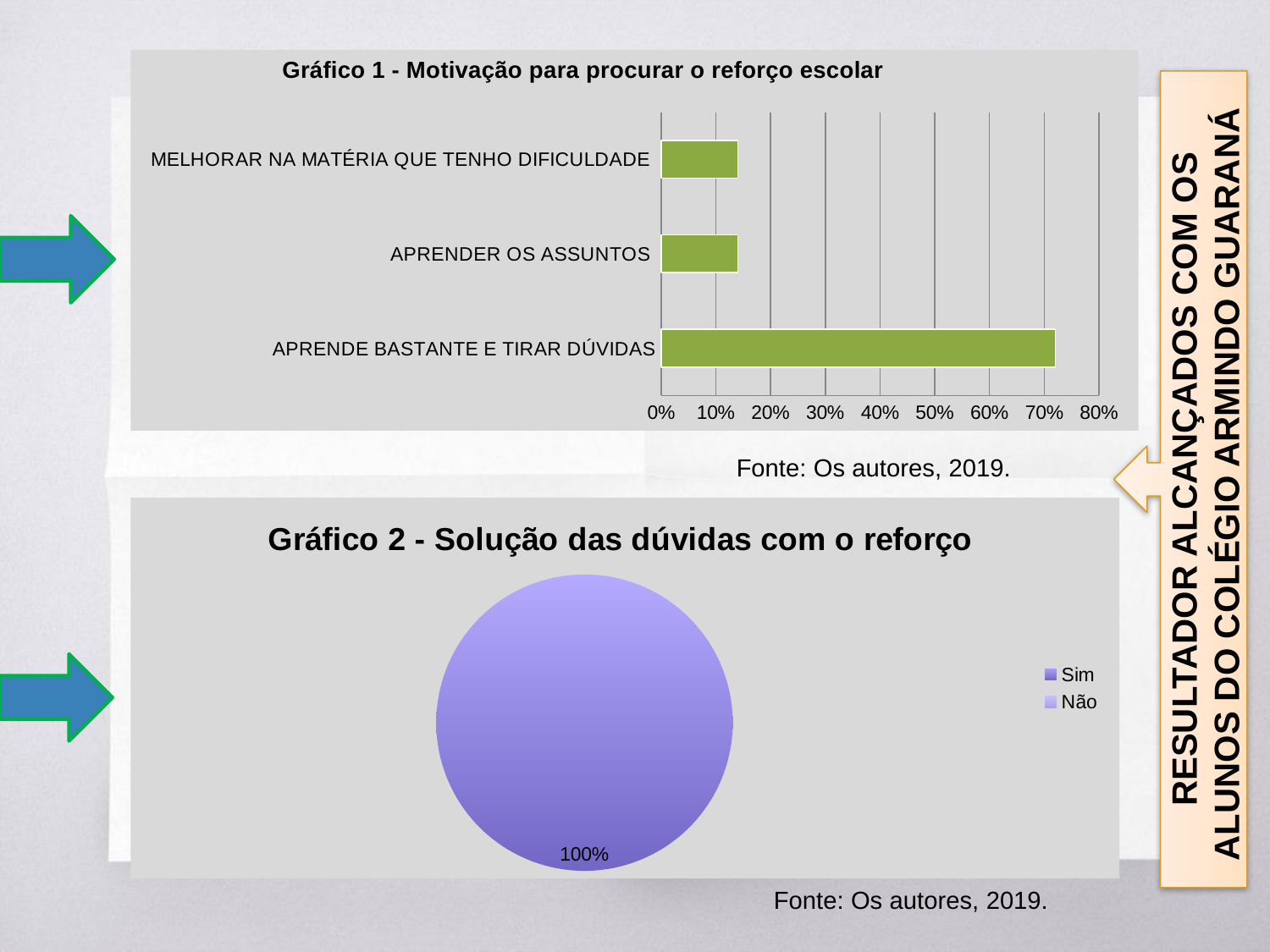
In Gráfico 2 - Solução das dúvidas com o reforço, what share of the pie does Sim represent? 100% In Gráfico 1 - Motivação para procurar o reforço escolar, is the value for APRENDER OS ASSUNTOS greater or less than 30%? less In Gráfico 1 - Motivação para procurar o reforço escolar, which is larger: APRENDE BASTANTE E TIRAR DÚVIDAS or APRENDER OS ASSUNTOS? APRENDE BASTANTE E TIRAR DÚVIDAS In Gráfico 1 - Motivação para procurar o reforço escolar, is the value for APRENDE BASTANTE E TIRAR DÚVIDAS greater or less than 60%? greater In Gráfico 1 - Motivação para procurar o reforço escolar, which category has the highest value? APRENDE BASTANTE E TIRAR DÚVIDAS What kind of chart is Gráfico 1 - Motivação para procurar o reforço escolar? bar chart How many entries does the legend of Gráfico 2 - Solução das dúvidas com o reforço list? 2 What kind of chart is Gráfico 2 - Solução das dúvidas com o reforço? pie chart How many categories are shown in Gráfico 1 - Motivação para procurar o reforço escolar? 3 In Gráfico 1 - Motivação para procurar o reforço escolar, is the value for MELHORAR NA MATÉRIA QUE TENHO DIFICULDADE greater or less than 20%? less What is the highest value shown on the x axis of Gráfico 1 - Motivação para procurar o reforço escolar? 80% What are the legend entries in Gráfico 2 - Solução das dúvidas com o reforço? Sim, Não